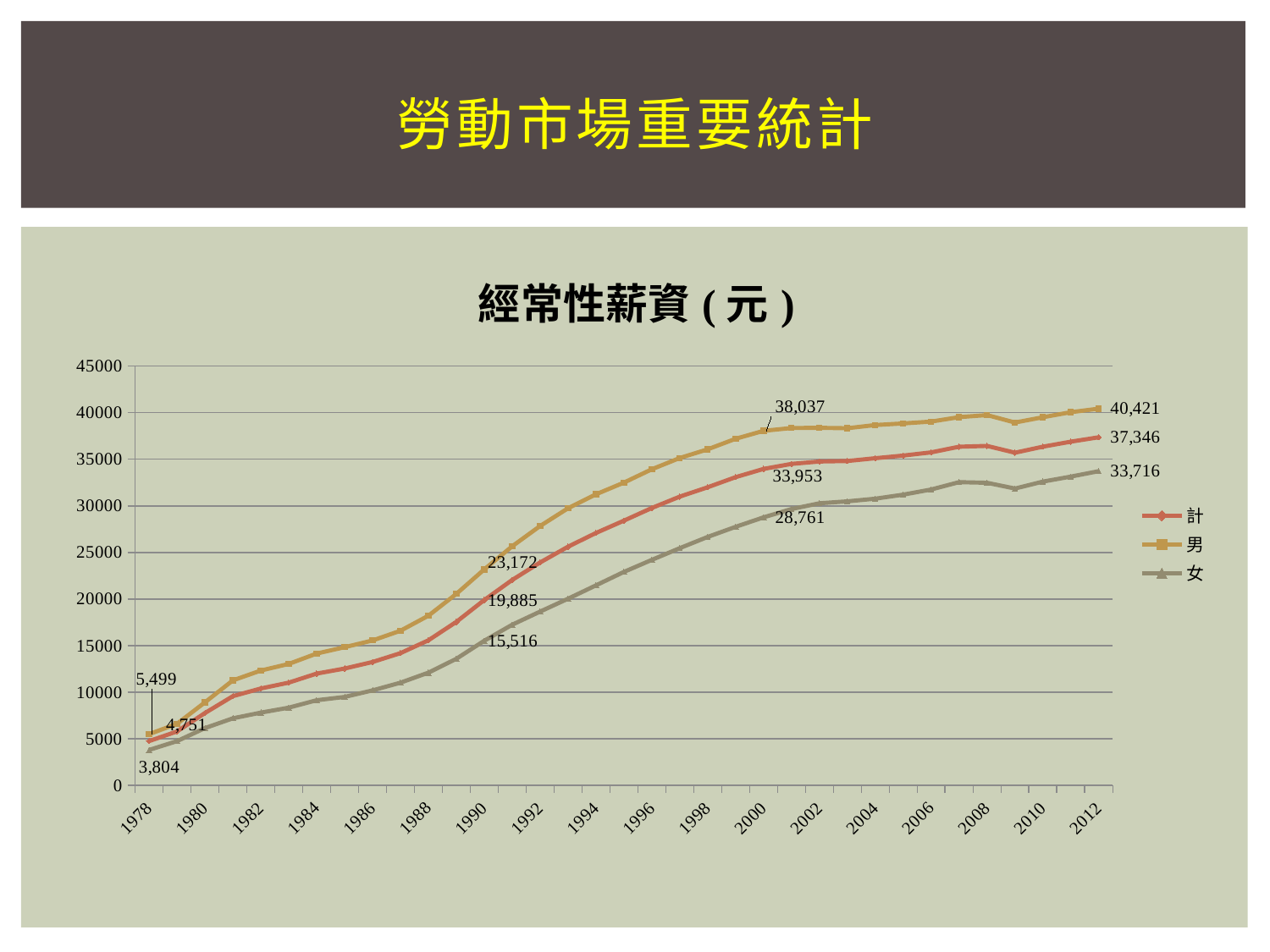
What is the value for 計 in 2000? 33,953 What is the value for 男 in 1990? 23,172 Which series has the lowest value in 1990? 女 What is the value for 女 in 1978? 3,804 Does the 女 series generally rise or fall from 1978 to 2012? rise What is the difference between the 計 value in 2000 and the 計 value in 1990? 14,068 What is the value for 男 in 2012? 40,421 What kind of chart is shown on the slide? line chart What is the title of the chart? 經常性薪資(元) Which series has the highest value in 2000? 男 What is the difference between the 男 and 女 values in 2012? 6,705 How many series does the legend list? 3